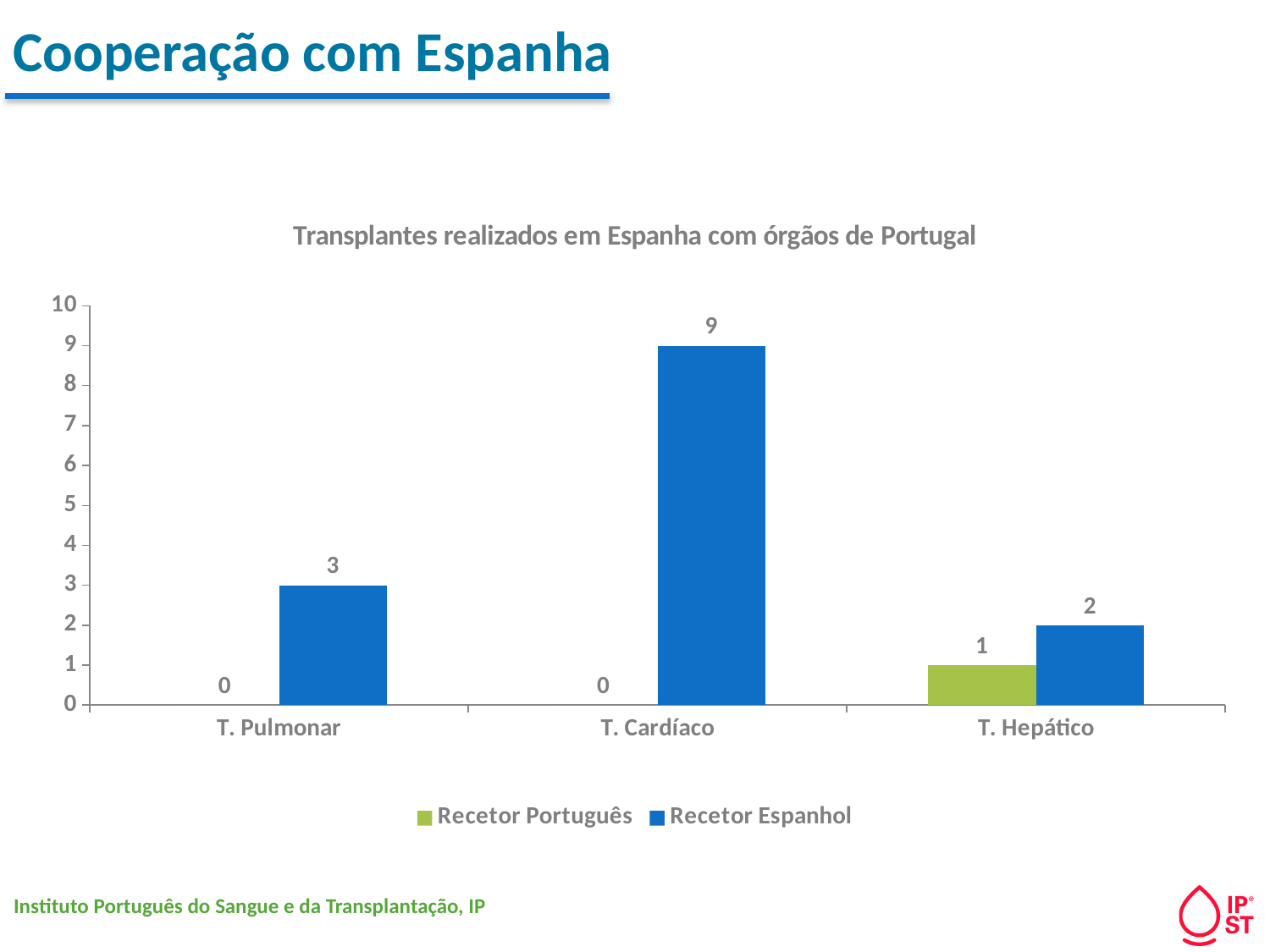
How many categories are shown on the x axis? 3 What is the difference between the Recetor Espanhol values for T. Cardíaco and T. Pulmonar? 6 Which category has the highest value for Recetor Espanhol? T. Cardíaco How many series does the legend list? 2 What is the value for Recetor Espanhol in the T. Pulmonar category? 3 What is the value for Recetor Português in the T. Pulmonar category? 0 What is the title of the chart? Transplantes realizados em Espanha com órgãos de Portugal Which category has the lowest value for Recetor Espanhol? T. Hepático In the T. Hepático category, which is larger: Recetor Português or Recetor Espanhol? Recetor Espanhol What is the value for Recetor Português in the T. Hepático category? 1 What is the value for Recetor Espanhol in the T. Cardíaco category? 9 What kind of chart is shown on the slide? Bar chart